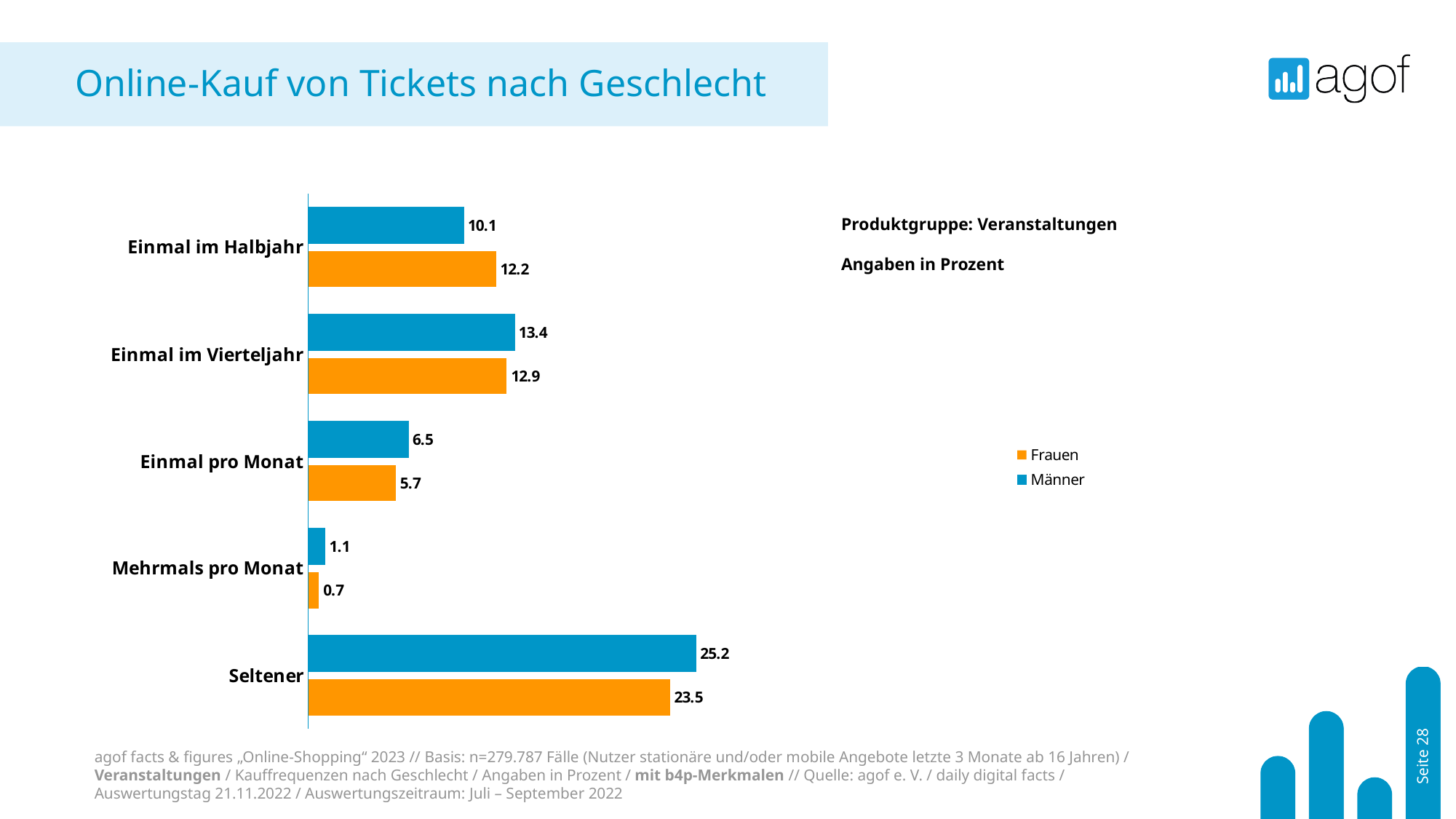
Which category has the lowest value for Männer? Mehrmals pro Monat How many categories are shown on the chart? 5 What is the difference between the Männer and Frauen values for Einmal im Halbjahr? 2.1 What is the value for Männer in the category Seltener? 25.2 Which colour represents the Frauen series? Orange Which category has the highest value for Frauen? Seltener What kind of chart is shown on the slide? Bar chart Which is larger in the category Einmal im Vierteljahr, the value for Frauen or for Männer? Männer How many series does the legend list? 2 What is the value for Frauen in the category Einmal im Halbjahr? 12.2 What is the value for Männer in the category Einmal pro Monat? 6.5 What is the difference between the Männer and Frauen values for Seltener? 1.7